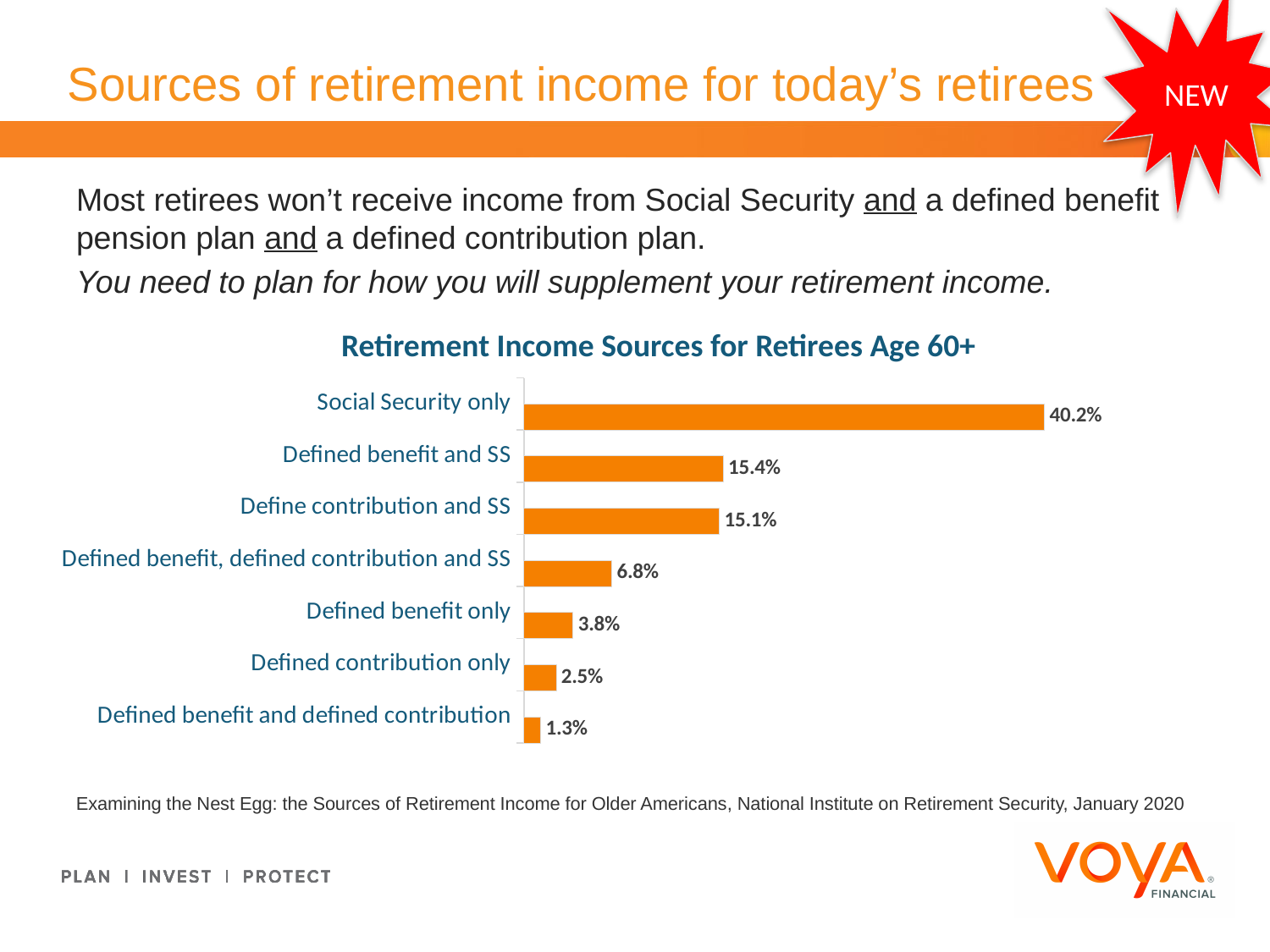
What is the difference between Defined benefit only and Defined contribution only? 1.3% What is the title of the chart? Retirement Income Sources for Retirees Age 60+ Which is larger, Defined benefit and SS or Define contribution and SS? Defined benefit and SS What is the value for Defined benefit and SS? 15.4% What kind of chart is this? Bar chart What is the value for Defined contribution only? 2.5% Which category has the lowest value? Defined benefit and defined contribution Which category has the highest value? Social Security only How many categories are shown in the chart? 7 What is the difference between Social Security only and Defined benefit and SS? 24.8% What is the value for Defined benefit, defined contribution and SS? 6.8% What is the value for Social Security only? 40.2%